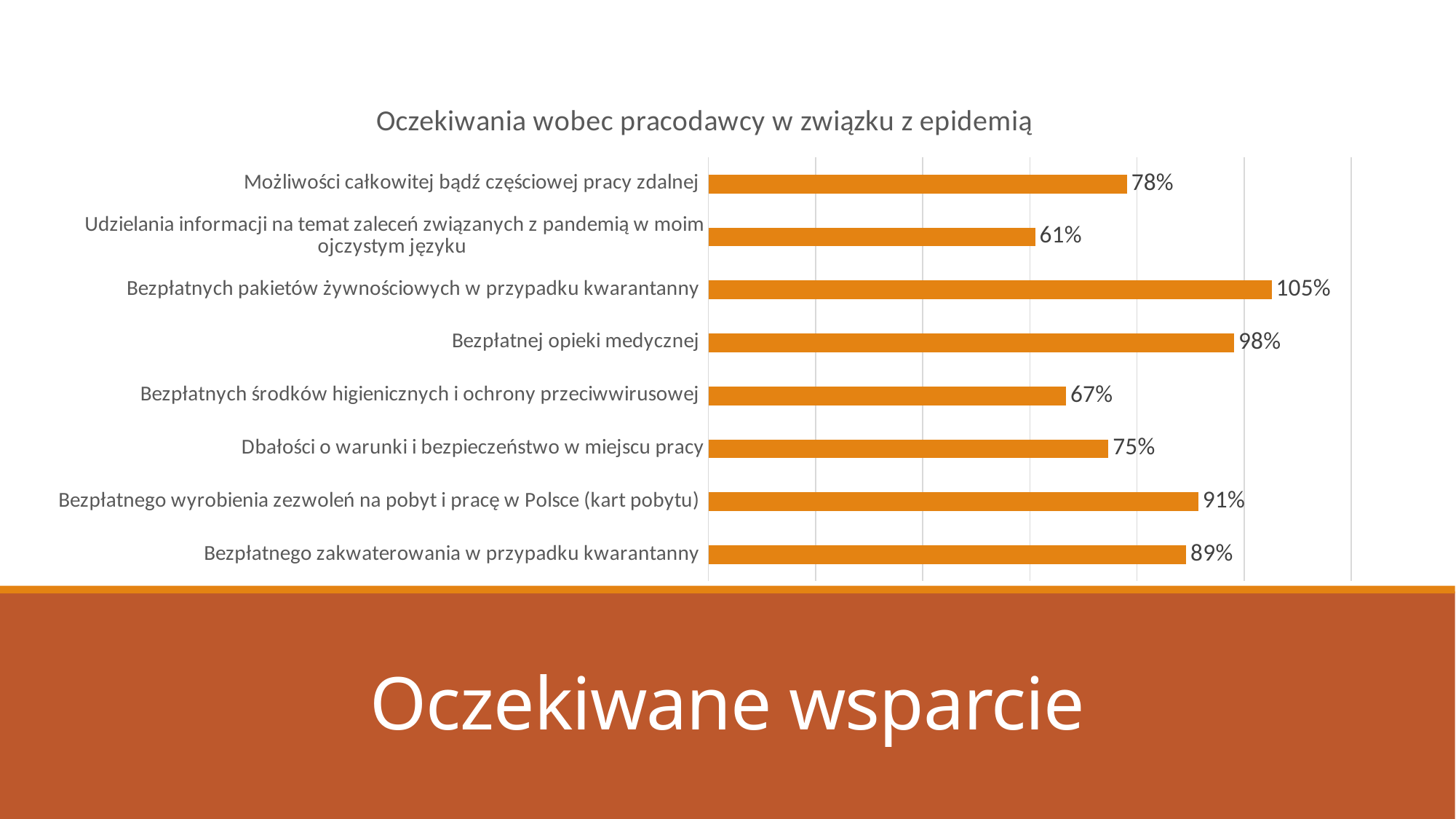
What is the title of the chart? Oczekiwania wobec pracodawcy w związku z epidemią What is the value for "Bezpłatnej opieki medycznej"? 98% What is the value for "Udzielania informacji na temat zaleceń związanych z pandemią w moim ojczystym języku"? 61% Which category has the highest value? Bezpłatnych pakietów żywnościowych w przypadku kwarantanny What is the difference between the values for "Bezpłatnych pakietów żywnościowych w przypadku kwarantanny" and "Bezpłatnej opieki medycznej"? 7% What is the difference between the values for "Bezpłatnego wyrobienia zezwoleń na pobyt i pracę w Polsce (kart pobytu)" and "Dbałości o warunki i bezpieczeństwo w miejscu pracy"? 16% What is the value for "Możliwości całkowitej bądź częściowej pracy zdalnej"? 78% What kind of chart is shown on the slide? Bar chart What is the value for "Bezpłatnego zakwaterowania w przypadku kwarantanny"? 89% Which is larger: the value for "Bezpłatnych środków higienicznych i ochrony przeciwwirusowej" or for "Dbałości o warunki i bezpieczeństwo w miejscu pracy"? Dbałości o warunki i bezpieczeństwo w miejscu pracy How many categories does the chart show? 8 Which category has the lowest value? Udzielania informacji na temat zaleceń związanych z pandemią w moim ojczystym języku